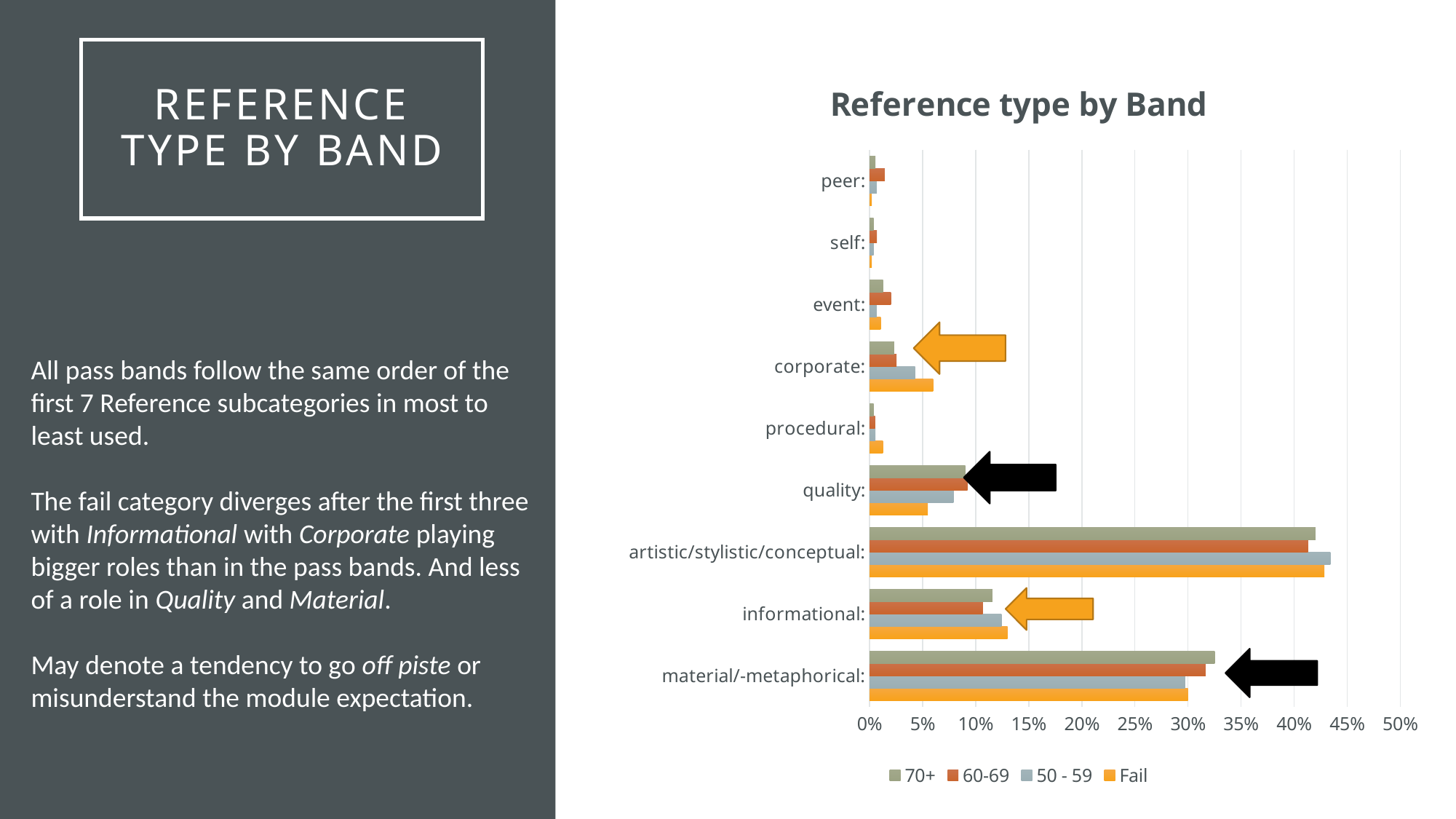
Within the corporate category, which band has the highest value? Fail How many series does the legend list? 4 Is the Fail value for informational greater or less than 10%? greater Is the 70+ value for material/-metaphorical greater or less than 30%? greater Which category has the highest values across all bands? artistic/stylistic/conceptual: Is the 70+ value for quality greater or less than 10%? less Within the quality category, which band has the lowest value? Fail How many reference type categories are plotted on the chart? 9 Which is larger: the Fail value for corporate or the 70+ value for corporate? Fail What is the title of the chart? Reference type by Band What kind of chart is shown on the slide? bar chart